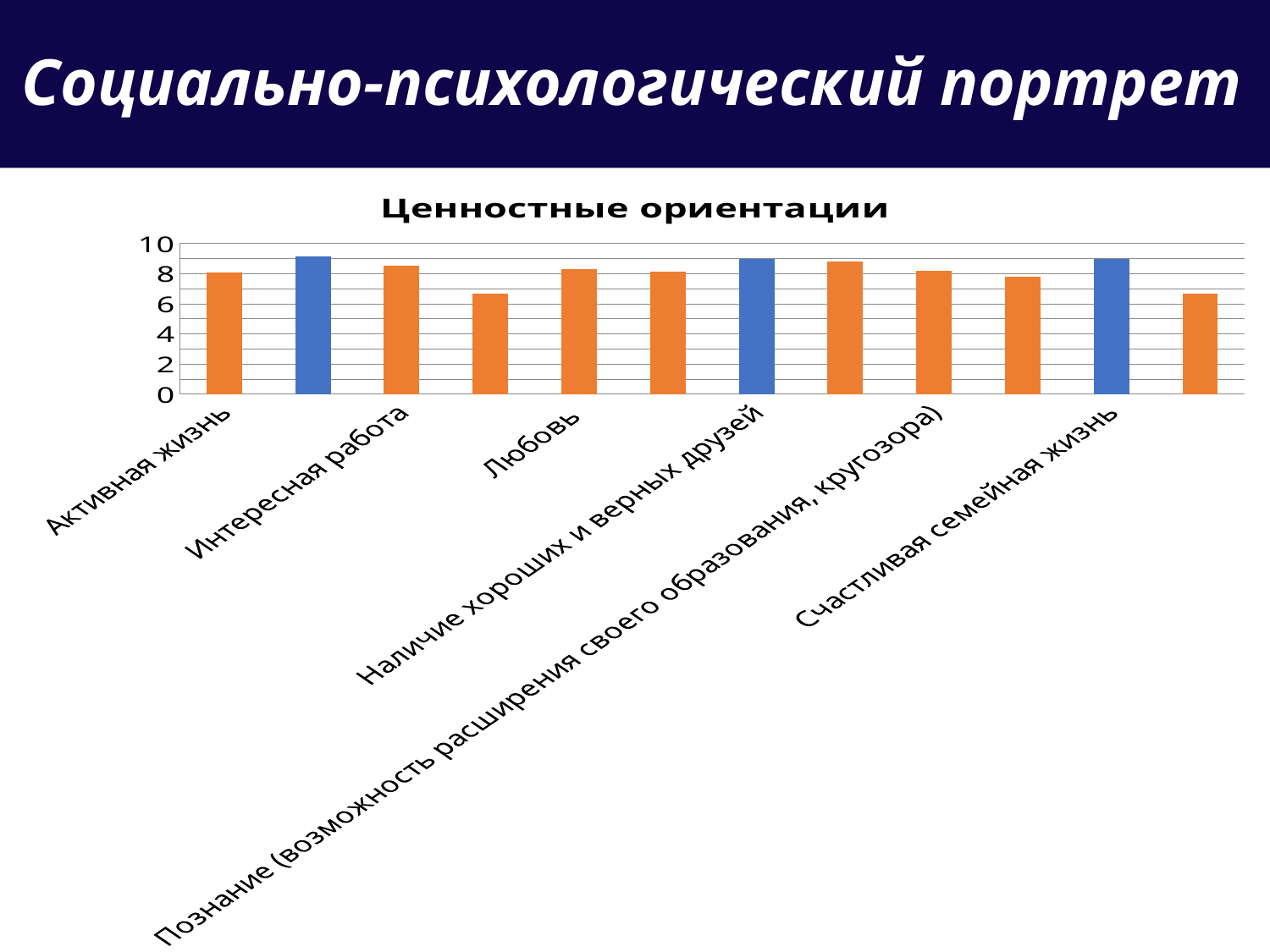
Is the value for Счастливая семейная жизнь greater or less than 10? less Which has the larger value: Счастливая семейная жизнь or Активная жизнь? Счастливая семейная жизнь Is the value for Любовь greater or less than 10? less How many bars in the chart are coloured blue? 3 How many bars are plotted in the chart? 12 Is the value for Интересная работа greater or less than 8? greater What type of chart is shown on the slide? Bar chart Which has the larger value: Наличие хороших и верных друзей or Познание (возможность расширения своего образования, кругозора)? Наличие хороших и верных друзей What is the title of the chart? Ценностные ориентации